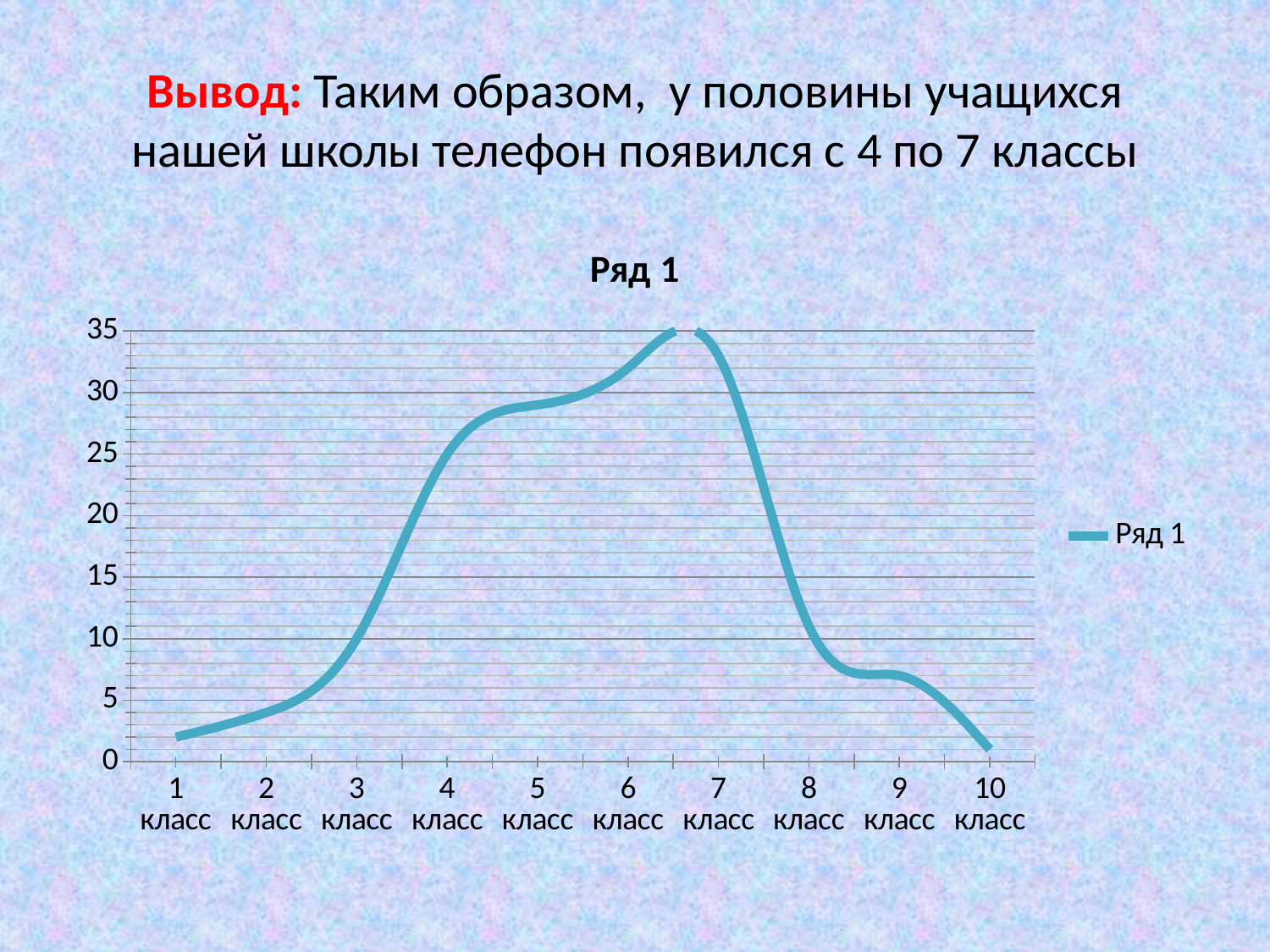
Which category has the lowest value on the chart? 10 класс How many series does the chart legend list? 1 Which category has the highest value on the chart? 7 класс Is the value for 4 класс greater or less than 20? greater Do the values rise or fall from 7 класс to 10 класс? fall Is the value for 5 класс greater or less than 25? greater Which has the larger value, 4 класс or 8 класс? 4 класс What kind of chart is shown on the slide? line chart Is the value for 8 класс greater or less than 15? less What is the title of the chart? Ряд 1 How many categories are shown on the x axis of the chart? 10